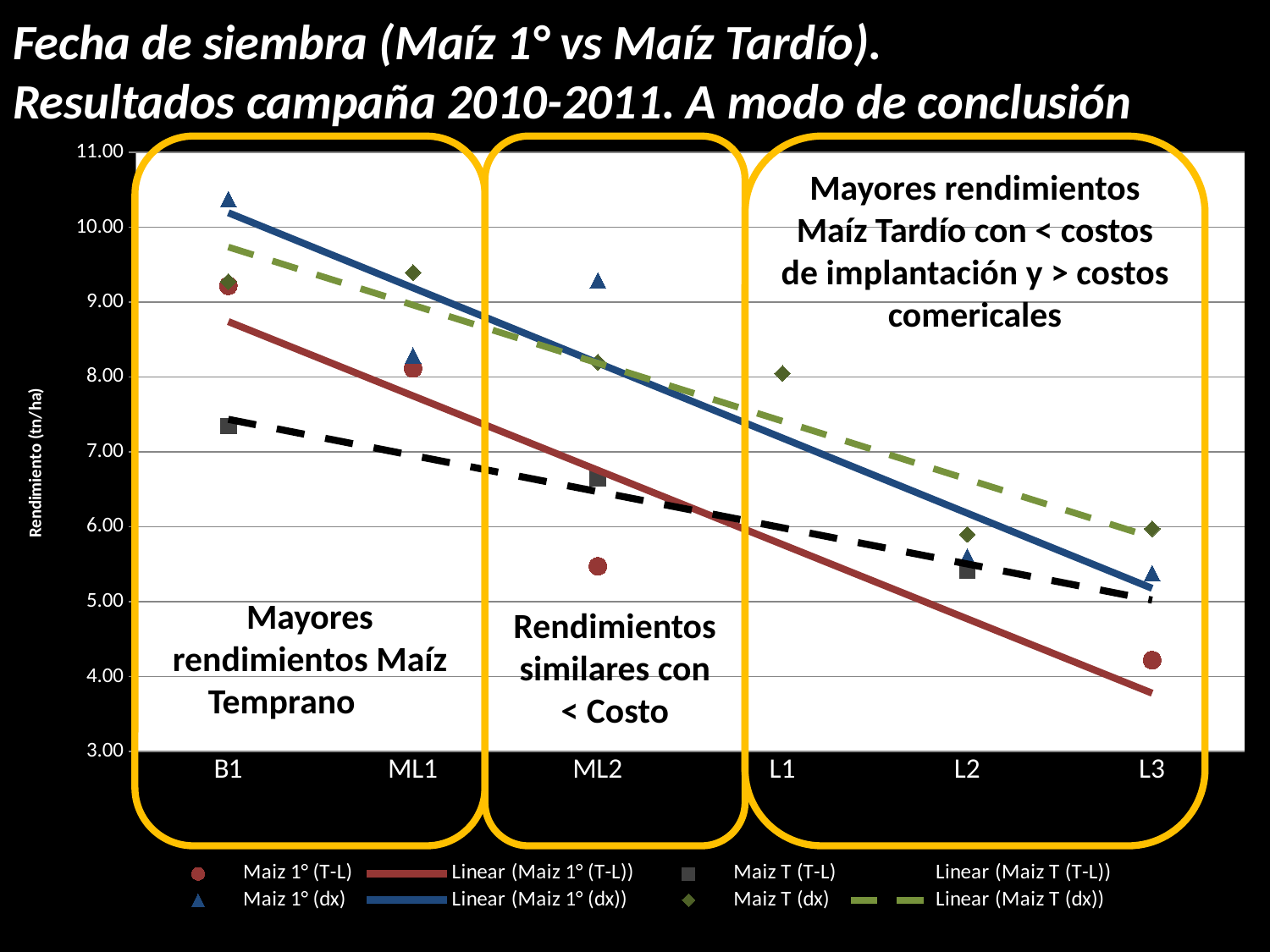
At B1, which is larger: Maiz 1° (dx) or Maiz T (T-L)? Maiz 1° (dx) Is the value for Maiz T (T-L) at L2 greater or less than 6.00? less What kind of chart is shown on the slide? Scatter chart with linear trend lines Is the value for Maiz 1° (T-L) at L3 greater or less than 5.00? less Is the value for Maiz 1° (T-L) at ML2 greater or less than 6.00? less How many entries does the legend list? 8 Do the linear trend lines rise or fall from B1 to L3? Fall How many categories are shown on the x axis? 6 At L3, which is larger: Maiz T (dx) or Maiz 1° (T-L)? Maiz T (dx) What is the label of the y axis? Rendimiento (tn/ha)